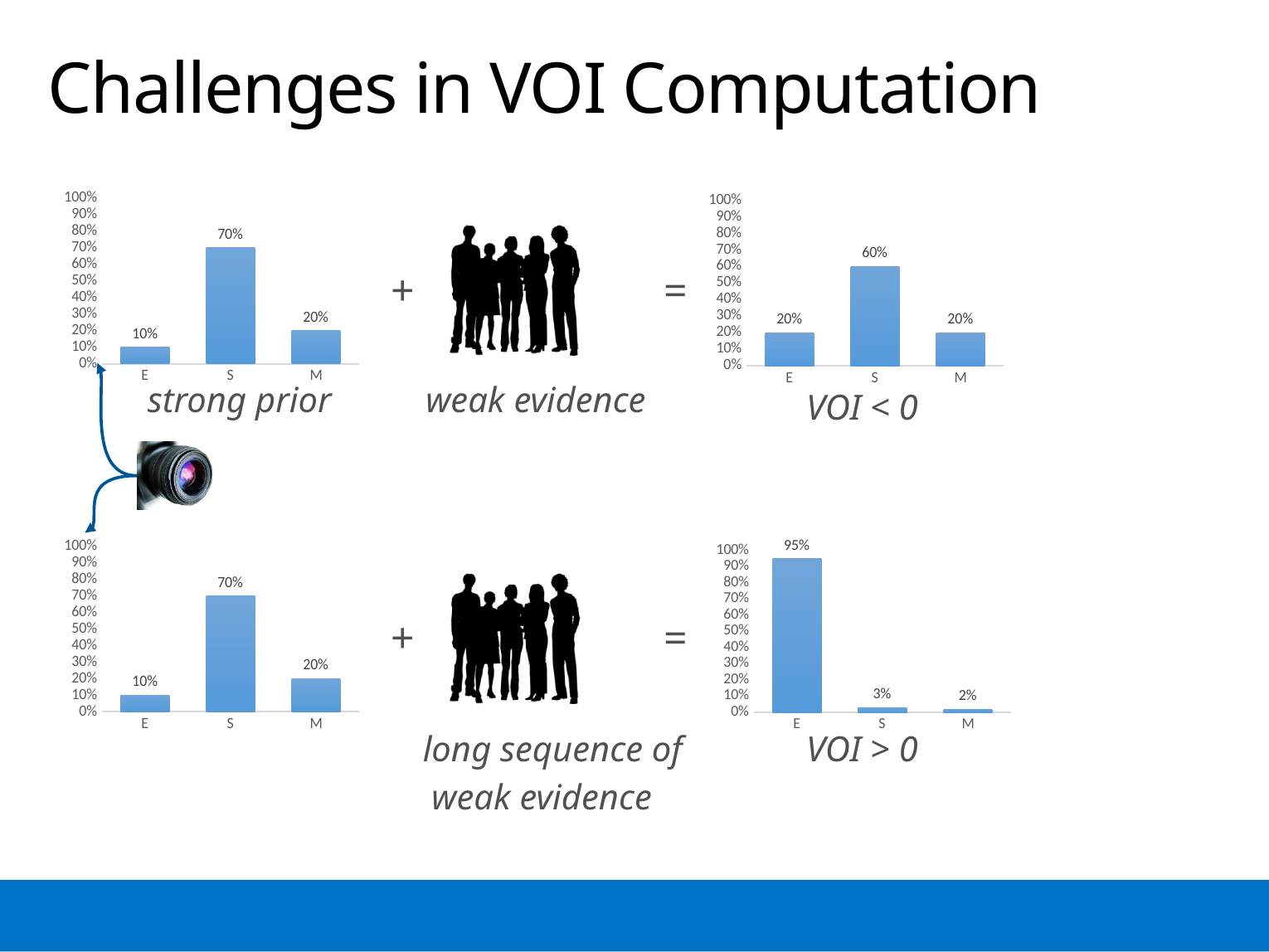
In the top-right chart (VOI < 0), what is the difference between the values for S and E? 40% In the bottom-right chart (VOI > 0), do the values rise or fall from E to M along the x axis? fall In the bottom-right chart (VOI > 0), which is larger, the value for S or the value for M? S How many categories are shown on the x axis of the top-right chart (VOI < 0)? 3 In the top-left chart (strong prior), what is the value for S? 70% In the bottom-right chart (VOI > 0), which category has the highest value? E In the top-right chart (VOI < 0), what is the value for S? 60% In the bottom-right chart (VOI > 0), what is the value for E? 95% In the bottom-right chart (VOI > 0), what is the value for M? 2% In the top-left chart (strong prior), which category has the lowest value? E What kind of chart is the bottom-left chart? bar chart In the top-left chart (strong prior), what is the value for E? 10%